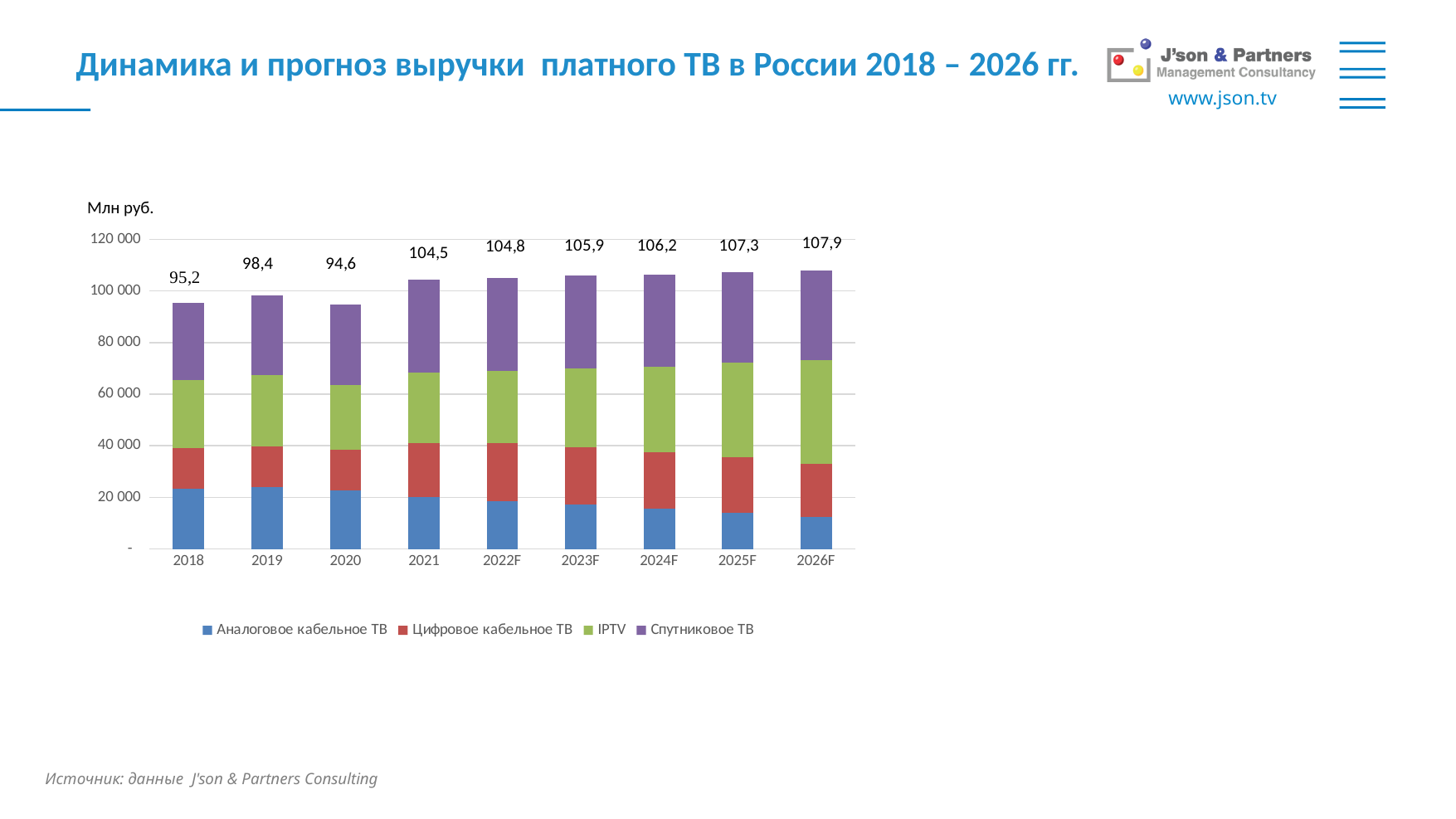
Which year has the highest labelled total? 2026F Do the labelled totals rise or fall from 2021 to 2026F? rise Which year has the larger labelled total, 2019 or 2020? 2019 What kind of chart is shown on the slide? stacked bar chart Is the total bar height for 2018 greater or less than 100 000 on the axis? less How many series does the legend list? 4 What is the total value labelled above the bar for 2021? 104,5 Which year has the lowest labelled total? 2020 How many years are shown on the x axis? 9 What is the total value labelled above the bar for 2018? 95,2 What is the difference between the labelled totals for 2026F and 2018? 12,7 What is the total value labelled above the bar for 2024F? 106,2